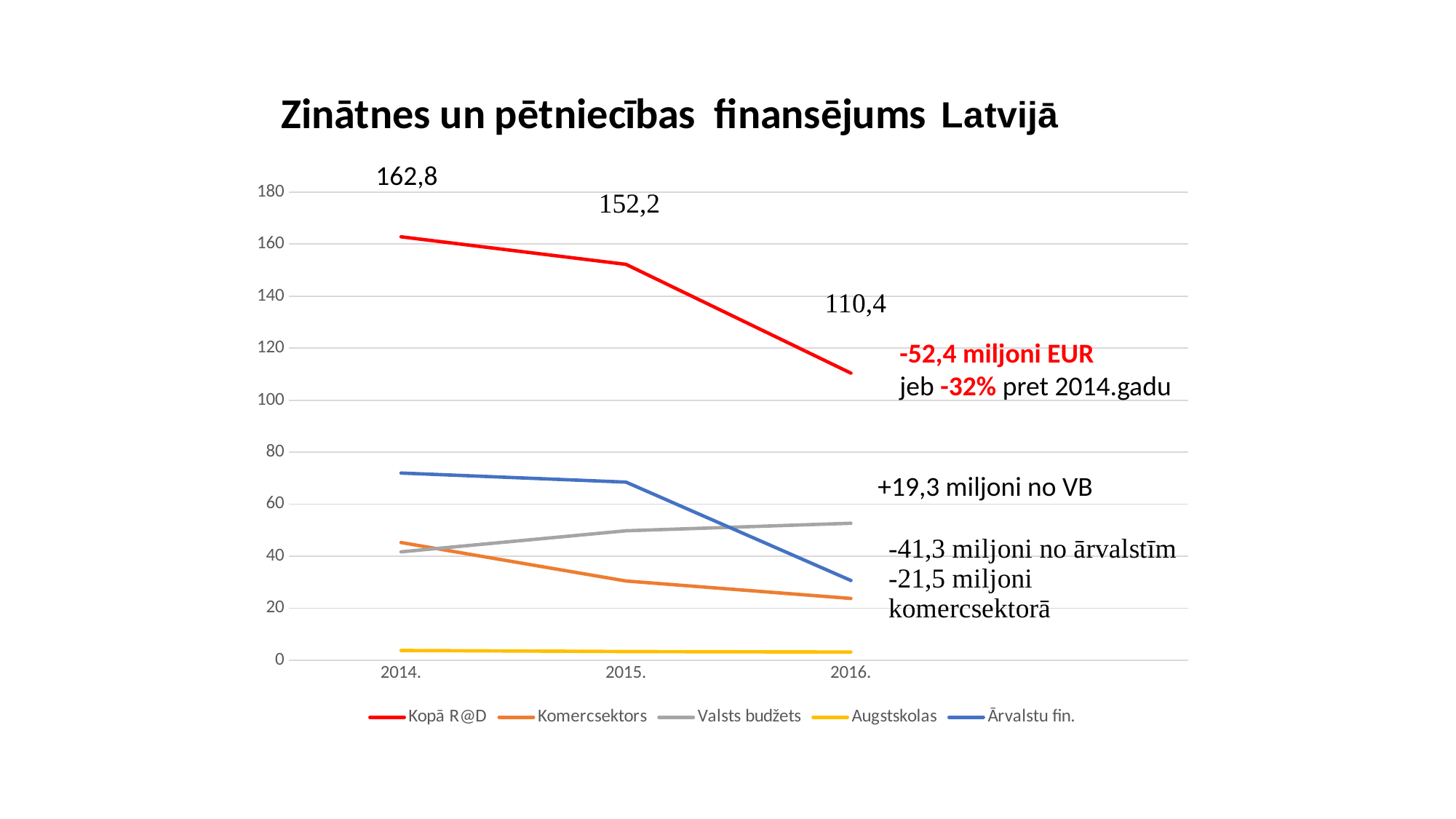
What is the value of Kopā R@D in 2016? 110,4 What is the value of Kopā R@D in 2015? 152,2 Which series has the lowest values across all years? Augstskolas What is the difference between the Kopā R@D values for 2014 and 2015? 10,6 In 2016, which is larger: Valsts budžets or Ārvalstu fin.? Valsts budžets What kind of chart is shown on the slide? line chart How many years are shown on the x axis? 3 What is the value of Kopā R@D in 2014? 162,8 Is the value for Ārvalstu fin. in 2014 greater or less than 60? greater Does the Kopā R@D line rise or fall from 2014 to 2016? fall By how much did Kopā R@D fall from 2014 to 2016? 52,4 How many series does the legend list? 5